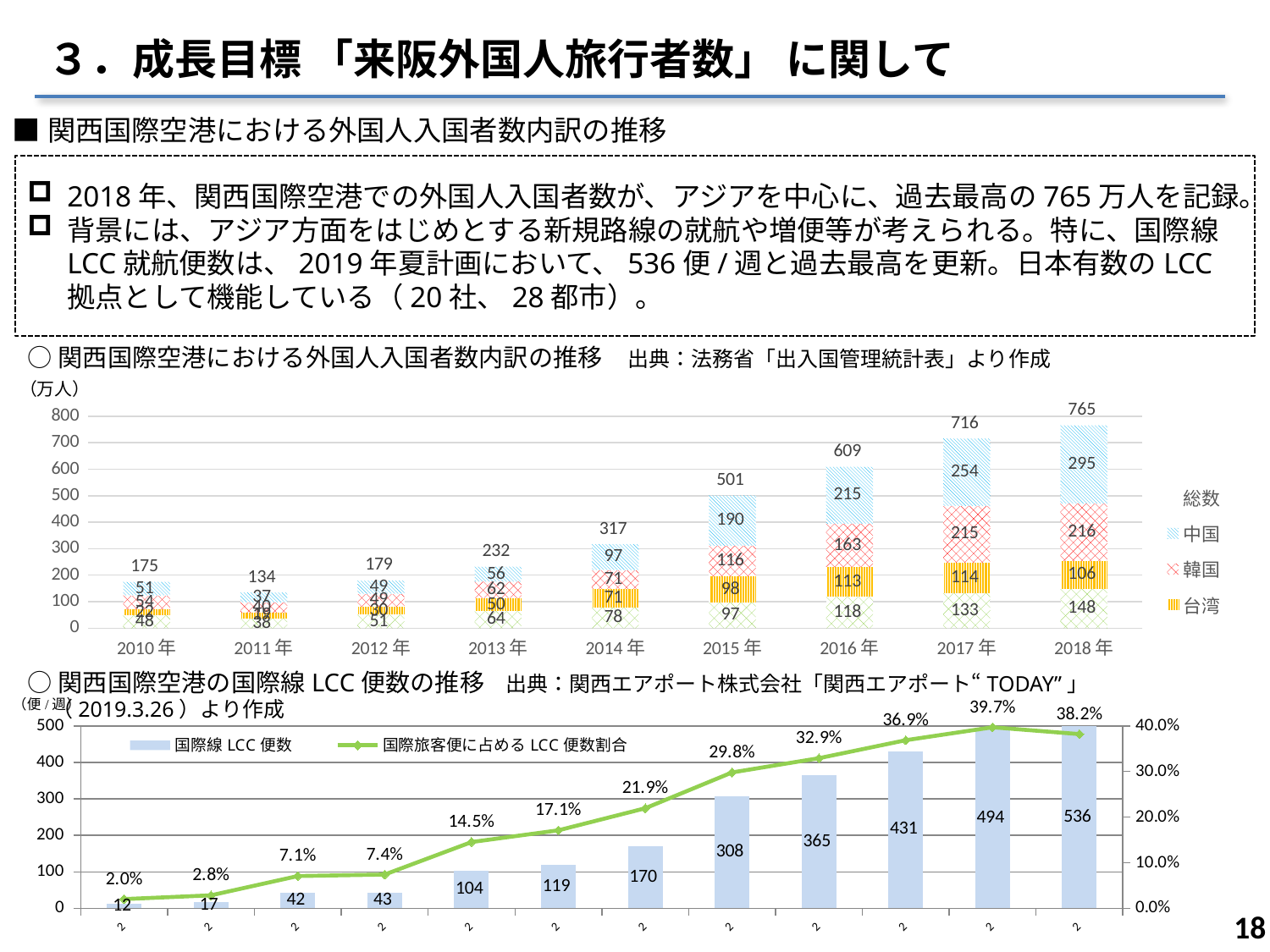
In the top chart, which is larger in 2016年, 中国 or 韓国? 中国 In the bottom chart, how many series does the legend list? 2 In the top chart, what is the difference between the totals for 2018年 and 2017年? 49 In the top chart (関西国際空港における外国人入国者数内訳の推移), what is the total (総数) for 2018年? 765 In the top chart, how many years are shown on the x axis? 9 In the top chart, what is the value for 韓国 in 2017年? 215 In the top chart, what is the value for 中国 in 2018年? 295 In the top chart, what is the value for 台湾 in 2016年? 113 In the bottom chart, what is the highest percentage shown for 国際旅客便に占めるLCC便数割合? 39.7% In the bottom chart (関西国際空港の国際線LCC便数の推移), what is the highest value of 国際線LCC便数 shown? 536 In the top chart, which year has the lowest total? 2011年 In the top chart, which year has the highest total? 2018年